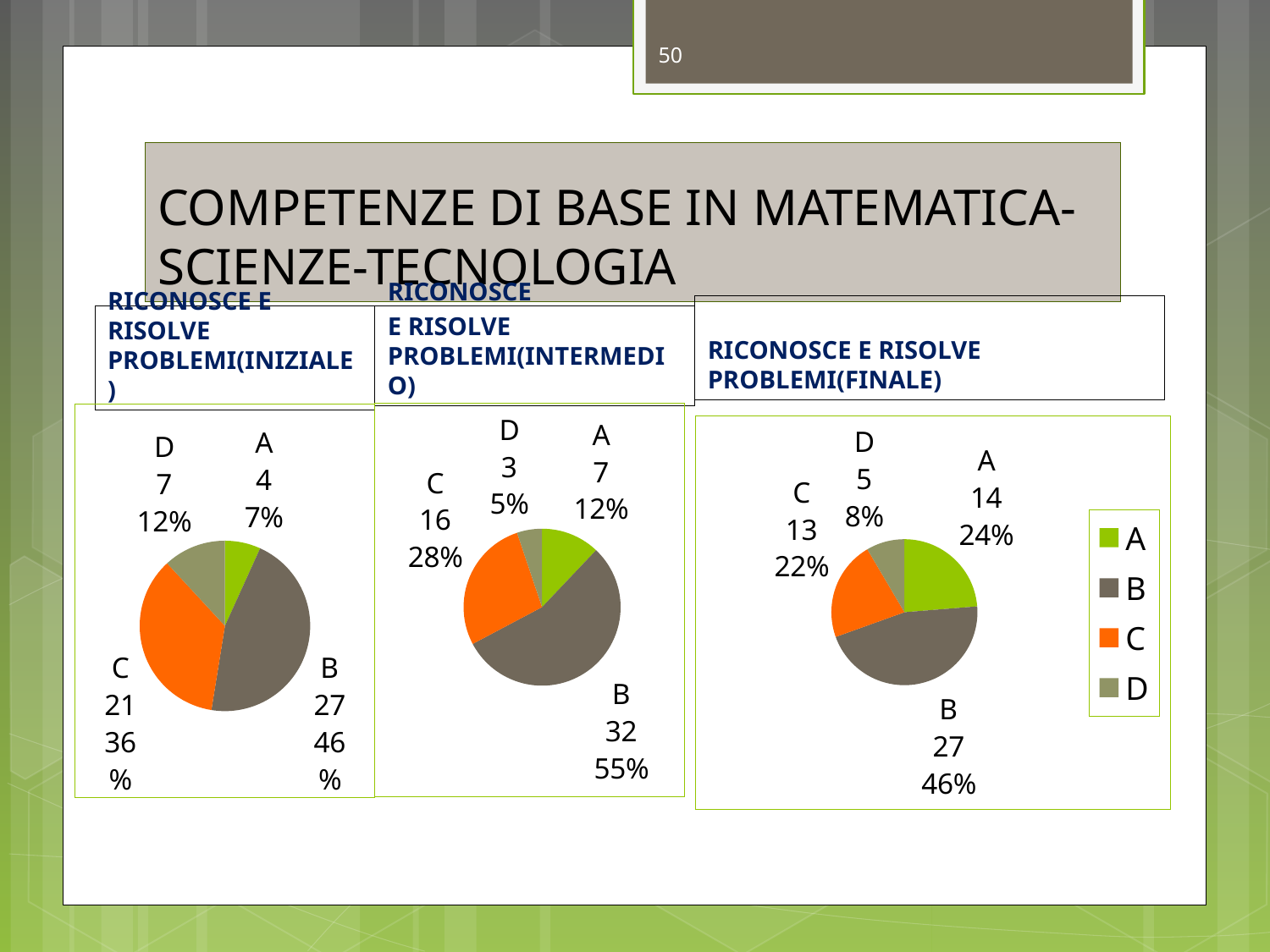
In the RICONOSCE E RISOLVE PROBLEMI(FINALE) pie chart, what is the difference between the counts for B and A? 13 In the RICONOSCE E RISOLVE PROBLEMI(FINALE) pie chart, what percentage does slice C represent? 22% How many entries does the legend on the right of the slide list? 4 What type of chart is used for RICONOSCE E RISOLVE PROBLEMI(INIZIALE)? Pie chart In the RICONOSCE E RISOLVE PROBLEMI(FINALE) pie chart, which is larger, the count for C or the count for D? C In the RICONOSCE E RISOLVE PROBLEMI(INIZIALE) pie chart, which category has the smallest slice? A In the RICONOSCE E RISOLVE PROBLEMI(FINALE) pie chart, what is the count shown for category A? 14 In the RICONOSCE E RISOLVE PROBLEMI(INTERMEDIO) pie chart, what percentage does slice B represent? 55% In the RICONOSCE E RISOLVE PROBLEMI(INTERMEDIO) pie chart, what is the count shown for category D? 3 In the RICONOSCE E RISOLVE PROBLEMI(INTERMEDIO) pie chart, which category has the largest slice? B In the RICONOSCE E RISOLVE PROBLEMI(INIZIALE) pie chart, what is the count shown for category C? 21 In the RICONOSCE E RISOLVE PROBLEMI(INIZIALE) pie chart, what percentage does slice B represent? 46%